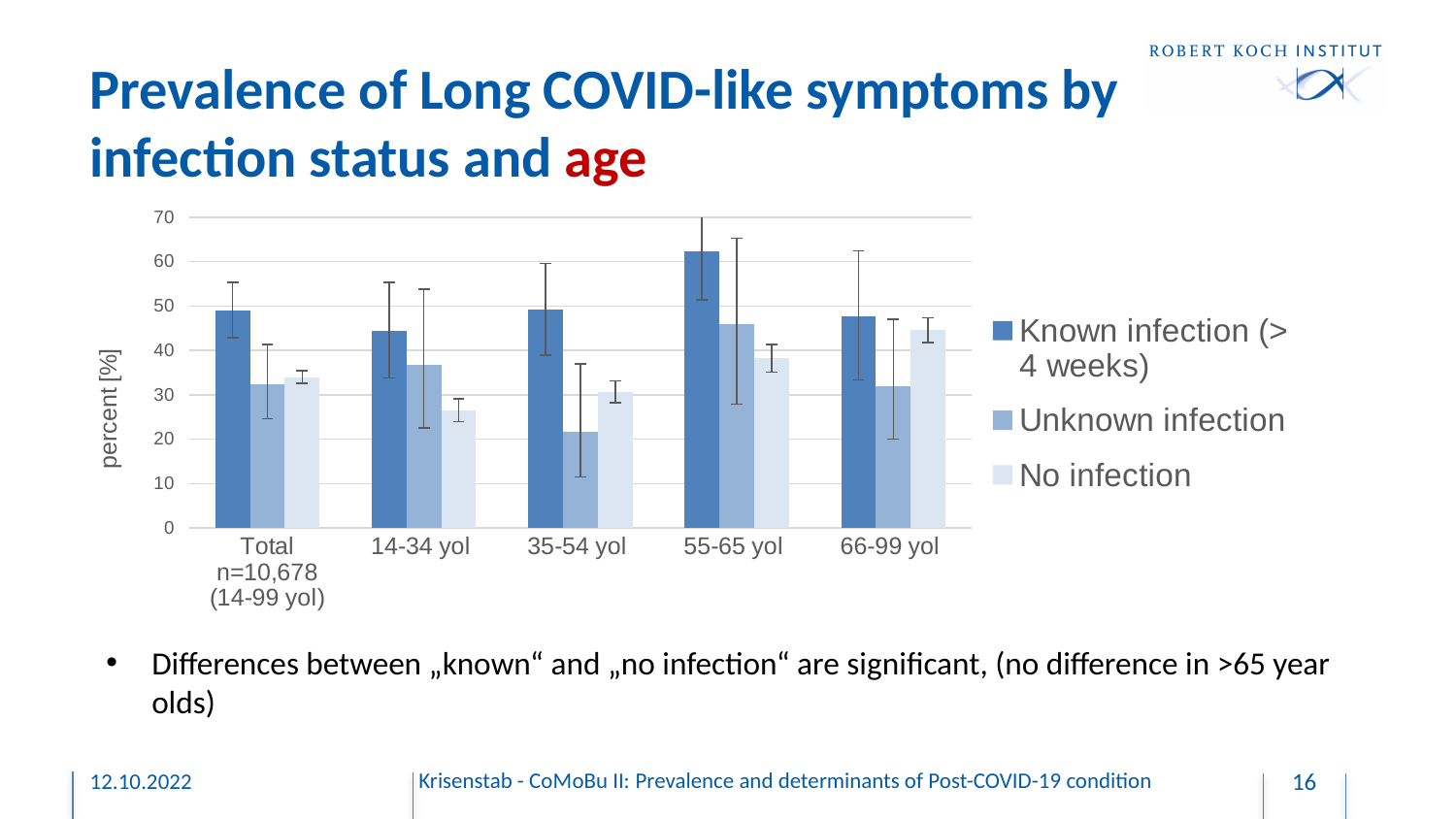
Which category has the lowest value for Unknown infection? 35-54 yol In the 66-99 yol group, which is larger: Unknown infection or No infection? No infection Is the value for Unknown infection in the 35-54 yol group greater or less than 30? less Is the value for Known infection (> 4 weeks) in the 55-65 yol group greater or less than 50? greater Which age category has the highest value for Known infection (> 4 weeks)? 55-65 yol In the Total group, which is larger: Known infection (> 4 weeks) or No infection? Known infection (> 4 weeks) How many categories are shown along the x axis? 5 How many series does the legend list? 3 What kind of chart is shown on the slide? bar chart Which category has the highest value for No infection? 66-99 yol What is the label of the y axis? percent [%] Is the value for No infection in the 14-34 yol group greater or less than 30? less